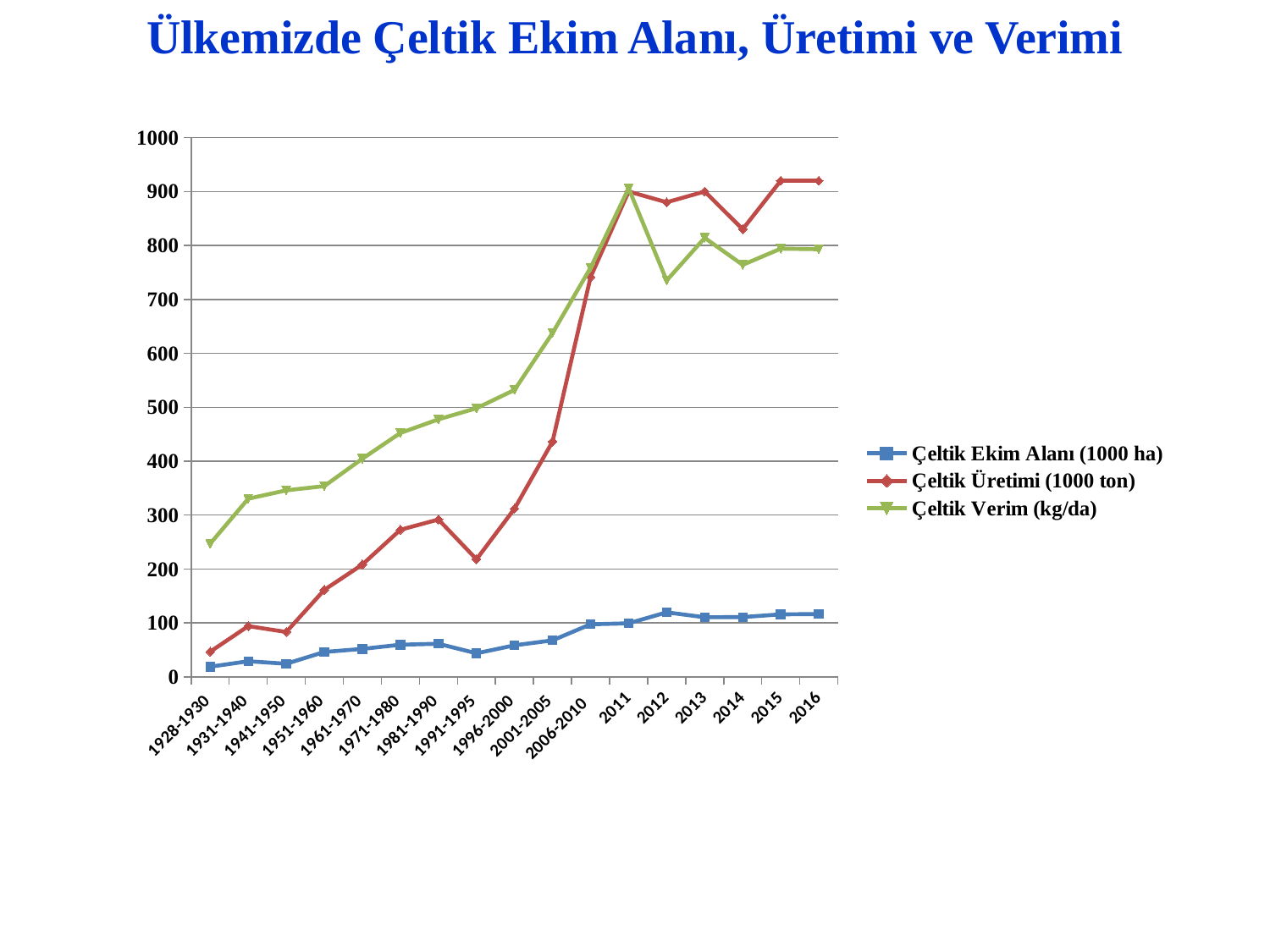
Is the value of Çeltik Ekim Alanı (1000 ha) for 1928-1930 greater or less than 100? less Is the value of Çeltik Verim (kg/da) for 2012 greater or less than 800? less For 2001-2005, which is larger: Çeltik Üretimi (1000 ton) or Çeltik Verim (kg/da)? Çeltik Verim (kg/da) How many categories are shown along the x axis? 17 What kind of chart is shown on the slide? Line chart What is the title of the chart? Ülkemizde Çeltik Ekim Alanı, Üretimi ve Verimi Which series is drawn in green? Çeltik Verim (kg/da) In which category is Çeltik Üretimi (1000 ton) lowest? 1928-1930 Is the value of Çeltik Üretimi (1000 ton) for 1991-1995 greater or less than 300? less How many series does the legend list? 3 In which category does Çeltik Verim (kg/da) reach its highest value? 2011